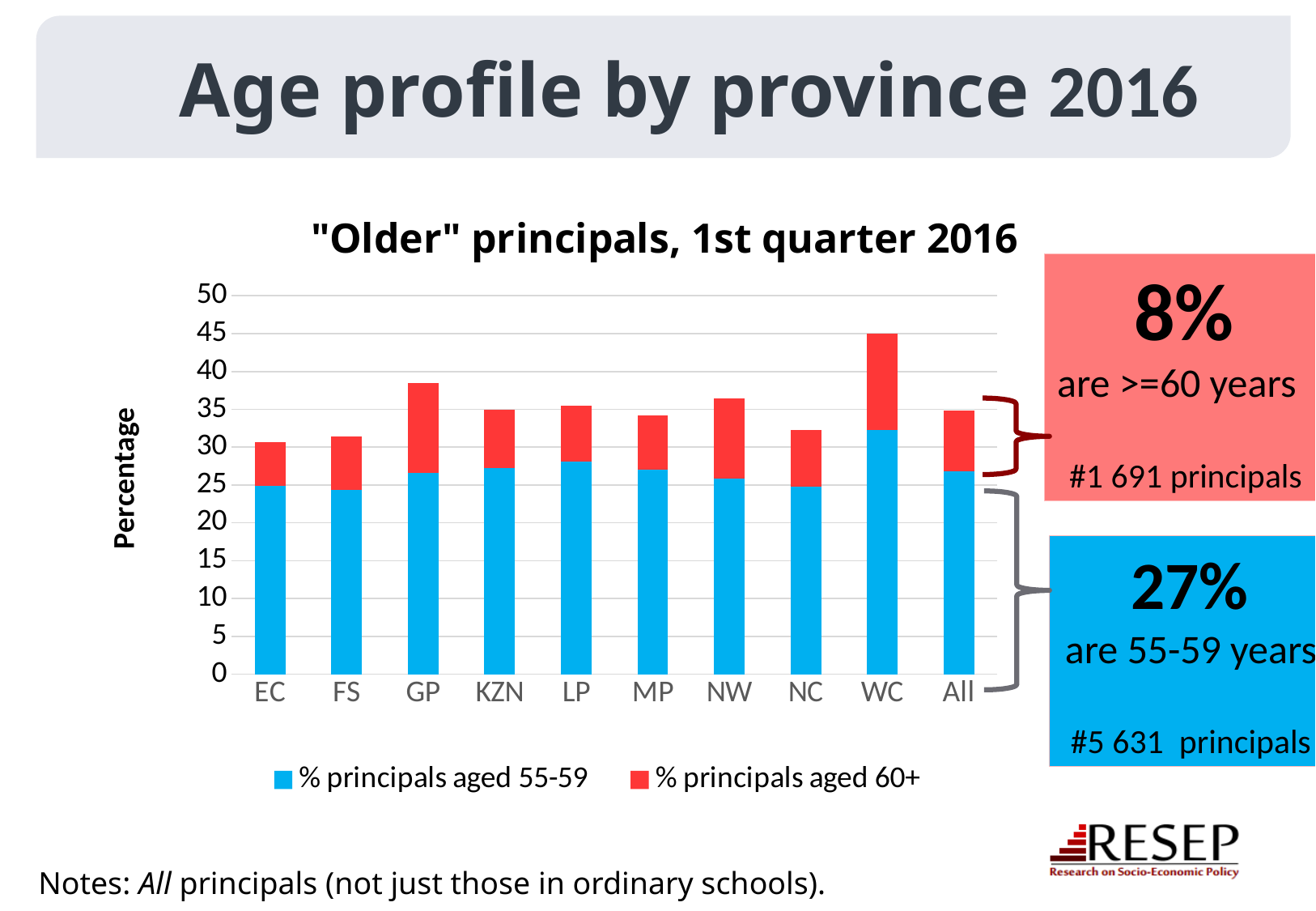
What is the title of the chart? "Older" principals, 1st quarter 2016 Is the total stacked bar for NC greater or less than 35? less Which category has the highest total stacked bar? WC How many categories are shown along the x axis of the chart? 10 Is the total stacked bar for GP greater or less than 35? greater According to the callout on the slide, what percentage of all principals are aged 55-59? 27% Is the total stacked bar for WC greater or less than 40? greater How many series does the chart's legend list? 2 Which has the larger total stacked bar, WC or NC? WC What kind of chart is shown on the slide? bar chart According to the callout on the slide, what percentage of all principals are aged 60 or over? 8%